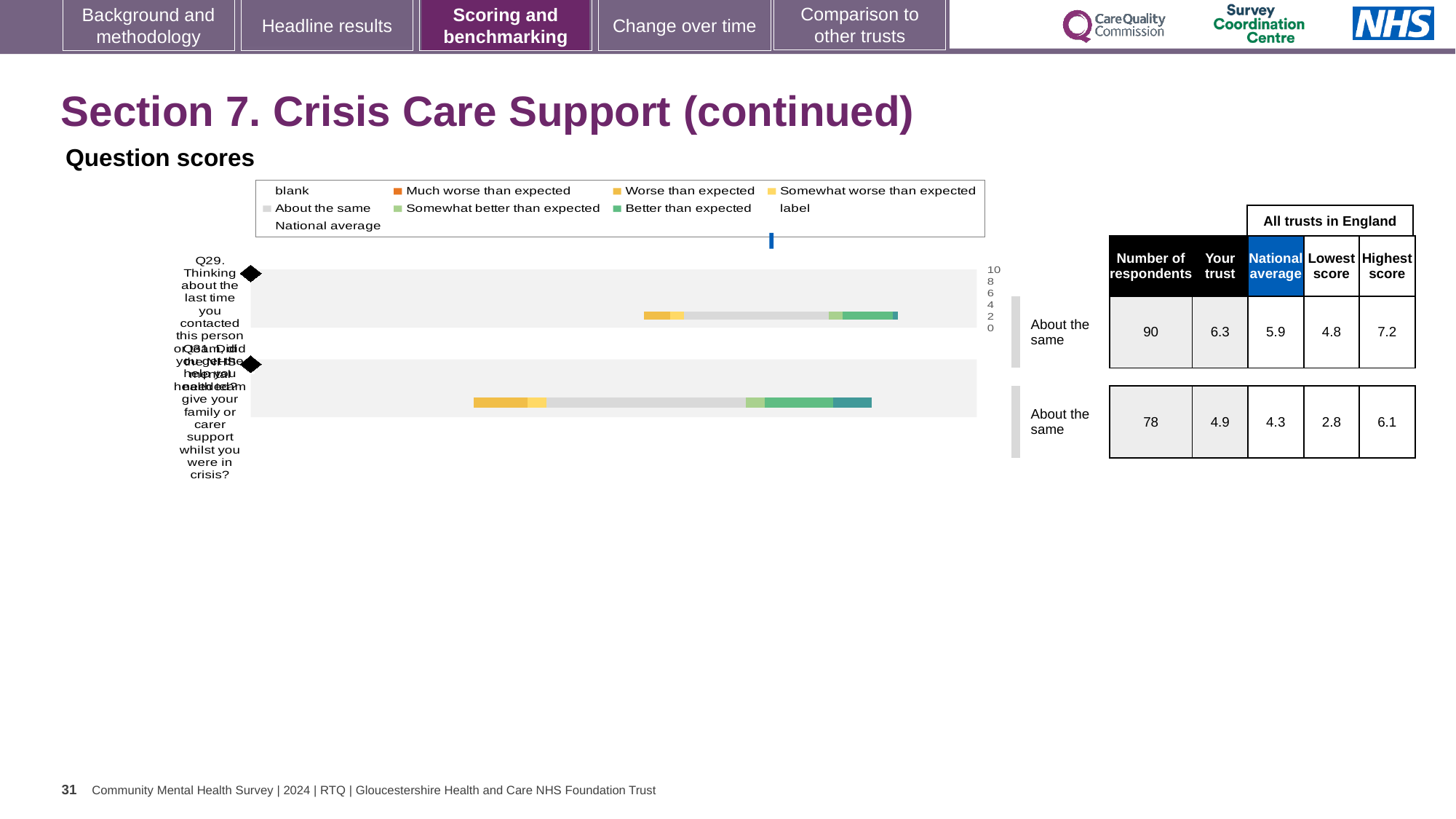
Which question has the higher 'Your trust' score in the table, Q29 or Q31? Q29 In the chart legend, what colour represents 'Much worse than expected'? orange What type of chart is used to show the question scores on this slide? bar chart In the table beside the chart, what is the difference between the highest score and the lowest score for Q29? 2.4 For Q29, which is larger in the table: the 'Your trust' score or the national average? Your trust What is the heading shown above the question scores chart? Question scores In the table beside the chart, what is the national average for Q31? 4.3 In the table beside the chart, what is the lowest score for Q31? 2.8 In the table beside the chart, what is the number of respondents for Q29? 90 What benchmark category is shown next to the chart for Q31? About the same In the table beside the chart, what is the 'Your trust' score for Q29? 6.3 How many questions (categories) are plotted in the question scores chart? 2